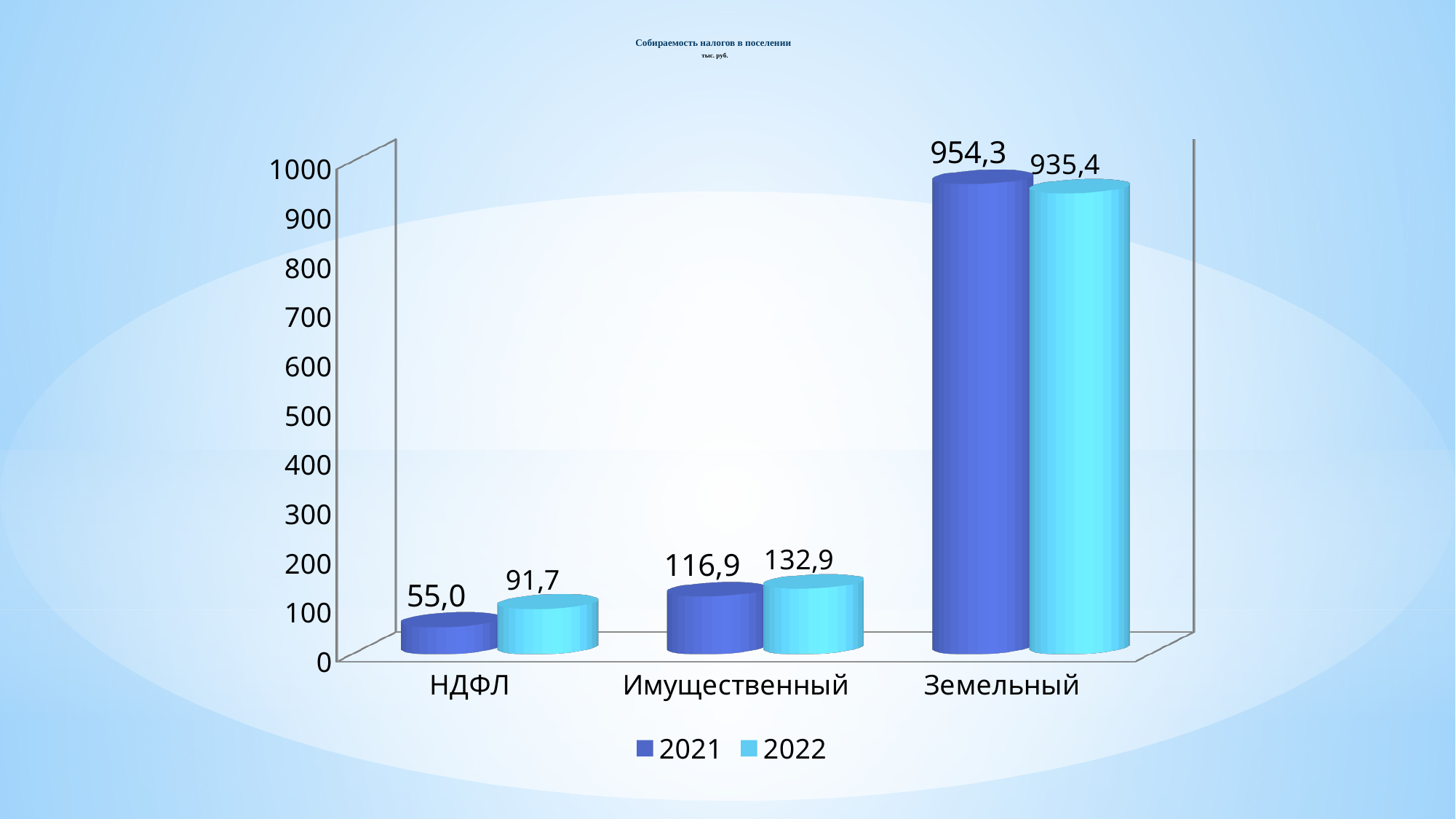
How many categories are shown on the x axis? 3 What is the difference between the 2021 and 2022 values for Земельный? 18,9 How many series does the legend list? 2 What is the difference between the 2022 and 2021 values for НДФЛ? 36,7 What is the value for Имущественный in 2022? 132,9 Is the value for Земельный in 2021 greater or less than 900? greater What kind of chart is shown on the slide? bar chart What is the value for Земельный in 2022? 935,4 Which category has the highest value in 2021? Земельный What is the value for НДФЛ in 2021? 55,0 Which is larger for Имущественный: the 2021 value or the 2022 value? 2022 Which category has the lowest value in 2022? НДФЛ